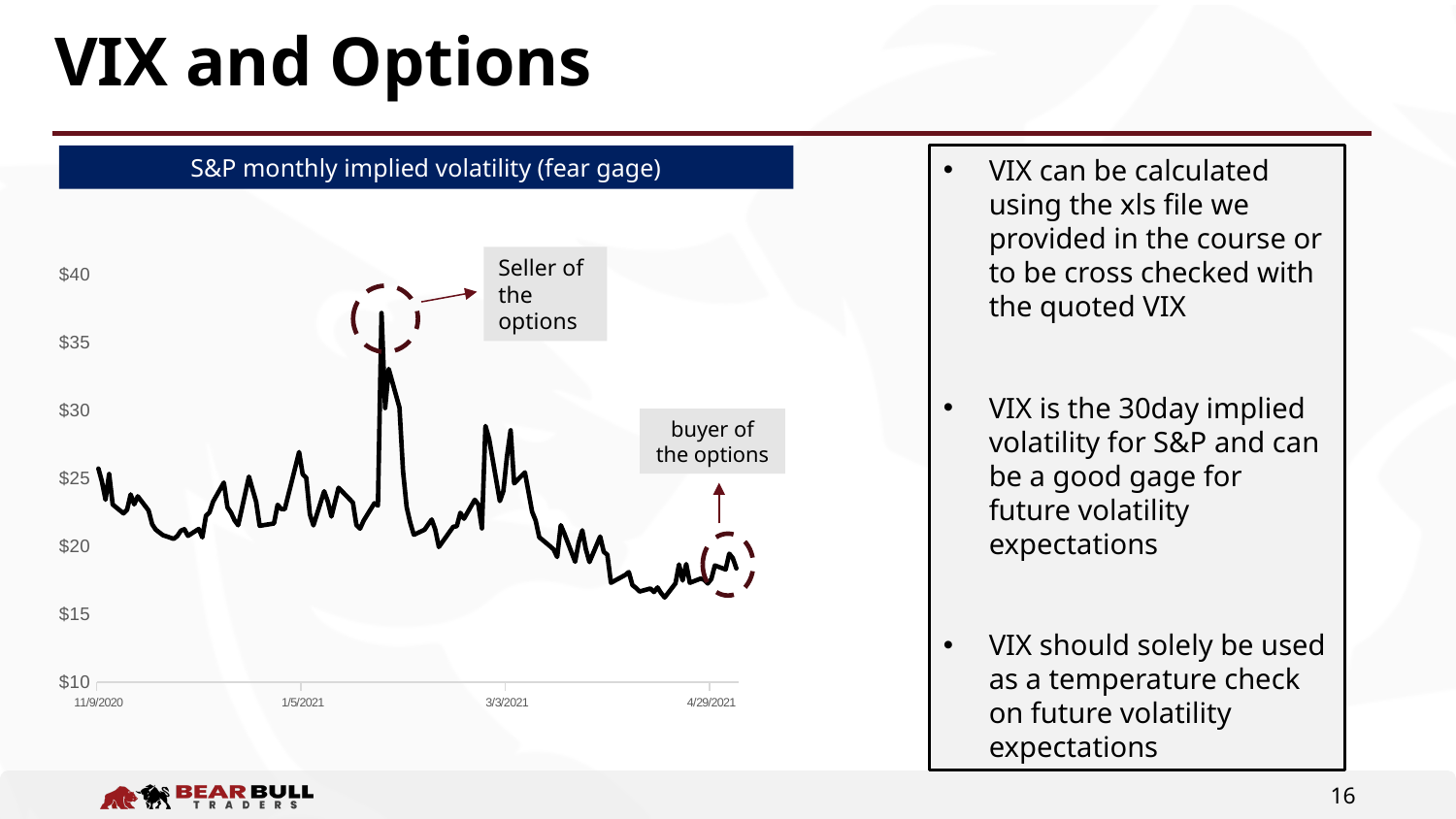
Is the value at 4/29/2021 greater or less than $20? less What is the title of the chart? S&P monthly implied volatility (fear gage) Is the value at 11/9/2020 greater or less than $20? greater How many date labels are shown on the x axis? 4 Is the value at 11/9/2020 higher or lower than the value at 4/29/2021? higher Overall, does the line rise or fall from the start of the x axis to the end? fall Is the peak value of the line greater or less than $35? greater What kind of chart is shown on the slide? line chart What is the highest value shown on the y axis? $40